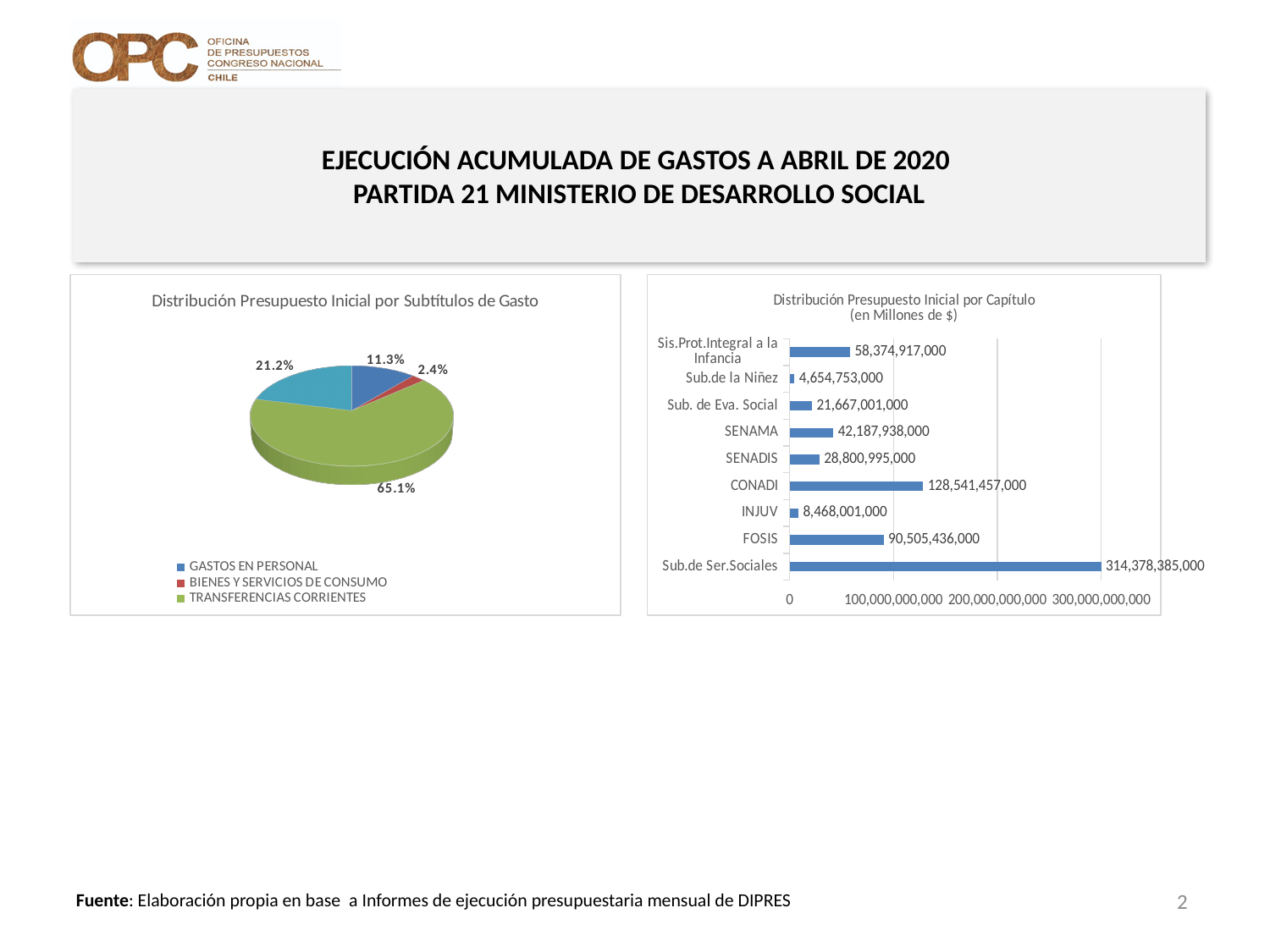
In the chart titled 'Distribución Presupuesto Inicial por Capítulo', what is the value for SENAMA? 42,187,938,000 In the chart titled 'Distribución Presupuesto Inicial por Capítulo', which is larger, the value for SENAMA or the value for SENADIS? SENAMA In the pie chart titled 'Distribución Presupuesto Inicial por Subtítulos de Gasto', what share does TRANSFERENCIAS CORRIENTES have? 65.1% In the chart titled 'Distribución Presupuesto Inicial por Capítulo', how many categories are shown? 9 In the chart titled 'Distribución Presupuesto Inicial por Capítulo', what is the difference between the values for CONADI and FOSIS? 38,036,021,000 In the chart titled 'Distribución Presupuesto Inicial por Capítulo', what is the value for Sub.de la Niñez? 4,654,753,000 In the pie chart titled 'Distribución Presupuesto Inicial por Subtítulos de Gasto', how many entries does the legend list? 3 In the chart titled 'Distribución Presupuesto Inicial por Capítulo', which category has the lowest value? Sub.de la Niñez What kind of chart is the chart titled 'Distribución Presupuesto Inicial por Capítulo'? Bar chart In the pie chart titled 'Distribución Presupuesto Inicial por Subtítulos de Gasto', what share does GASTOS EN PERSONAL have? 11.3% In the chart titled 'Distribución Presupuesto Inicial por Capítulo', which category has the highest value? Sub.de Ser.Sociales In the chart titled 'Distribución Presupuesto Inicial por Capítulo', what is the value for CONADI? 128,541,457,000